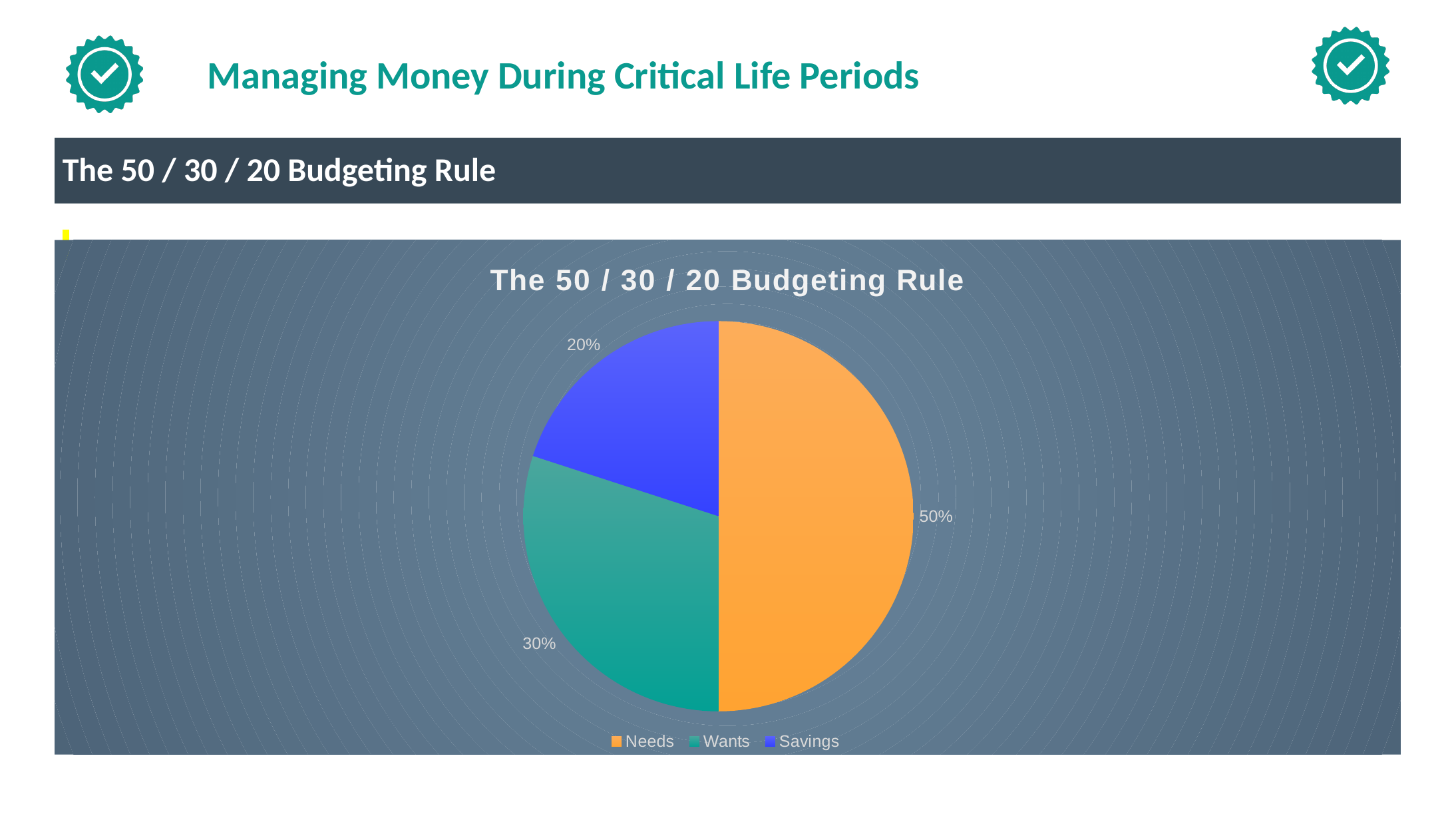
Which is larger, the Wants slice or the Savings slice? Wants What percentage of the pie is Wants? 30% What kind of chart is shown on the slide? pie chart What colour is the Needs slice? orange How many slices does the pie chart have? 3 Which category has the smallest slice of the pie? Savings Which category has the largest slice of the pie? Needs What percentage of the pie is Savings? 20% What is the difference in percentage points between Needs and Savings? 30 What percentage of the pie is Needs? 50% How many entries does the legend list? 3 What is the title of the chart? The 50 / 30 / 20 Budgeting Rule